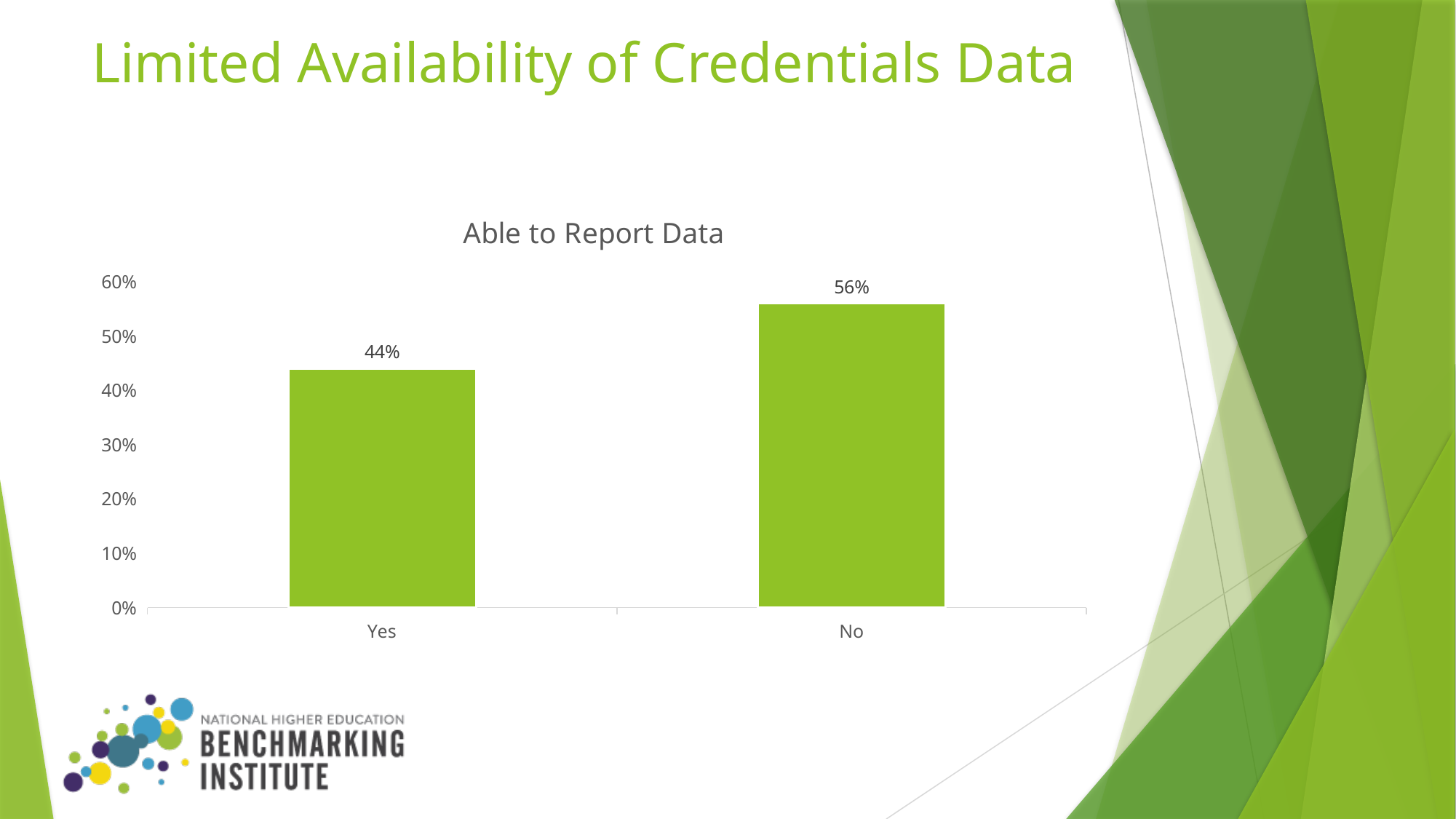
What kind of chart is shown on the slide? bar chart What is the value for Yes? 44% What is the difference between the values for No and Yes? 12% Is the value for Yes greater or less than 50%? less Which is larger, the value for Yes or the value for No? No Which category has the highest value? No What is the total of the two values shown? 100% What is the value for No? 56% Is the value for No greater or less than 50%? greater How many categories are shown on the x axis? 2 Which category has the lowest value? Yes What is the title of the chart? Able to Report Data